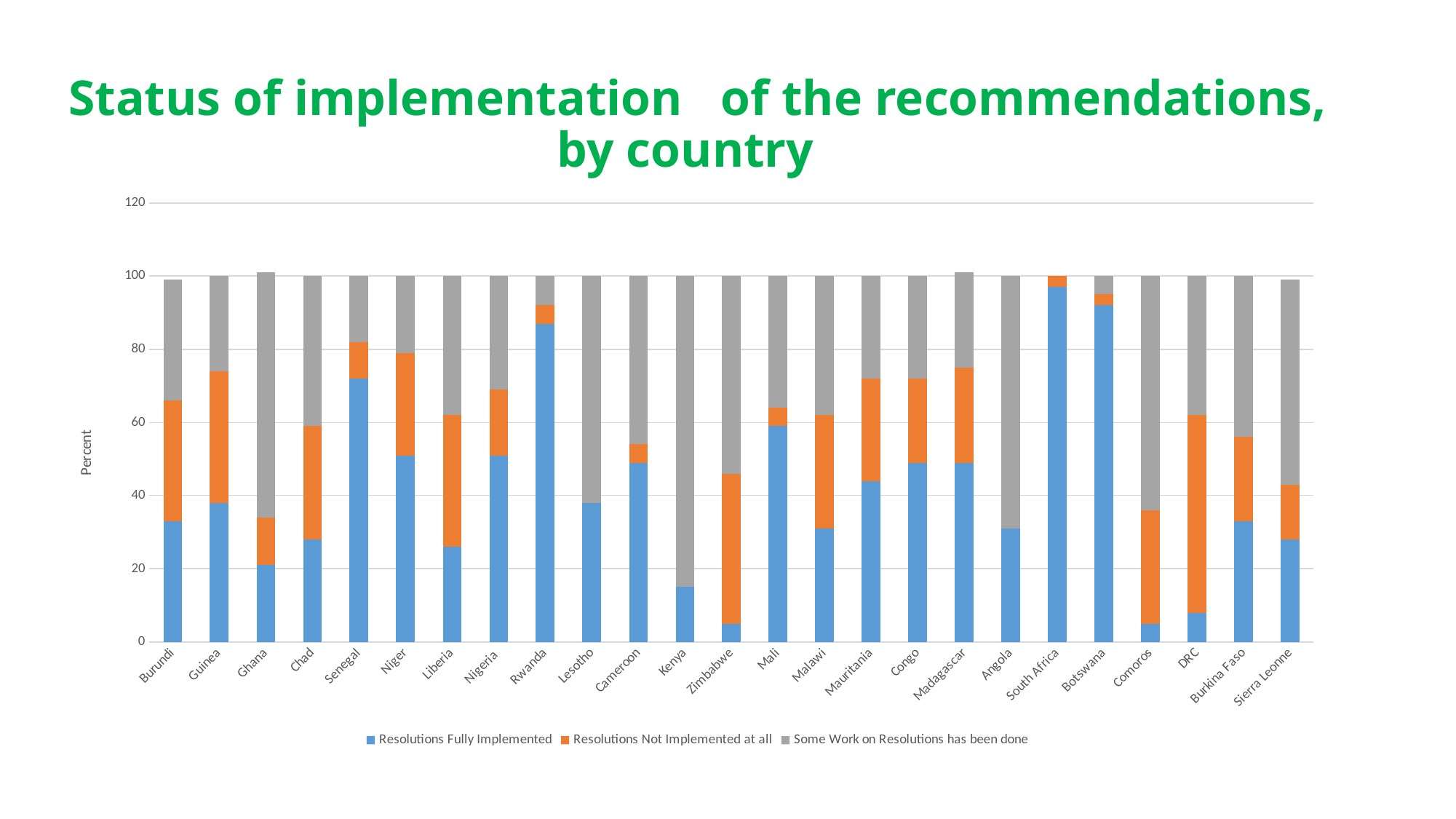
Is the value for Resolutions Fully Implemented for Rwanda greater or less than 80? greater How many series does the chart's legend list? 3 Which has the larger value for Resolutions Fully Implemented, Senegal or Chad? Senegal What kind of chart is shown on the slide? Stacked bar chart Is the value for Resolutions Fully Implemented for Kenya greater or less than 20? less What is the label on the vertical axis of the chart? Percent How many countries are shown on the x axis of the chart? 25 Which country has the highest value for Resolutions Fully Implemented? South Africa Which country has the largest segment for Some Work on Resolutions has been done? Kenya Is the value for Resolutions Fully Implemented for Senegal greater or less than 60? greater What is the title of the chart on the slide? Status of implementation of the recommendations, by country Which has the larger value for Resolutions Fully Implemented, Mali or Malawi? Mali